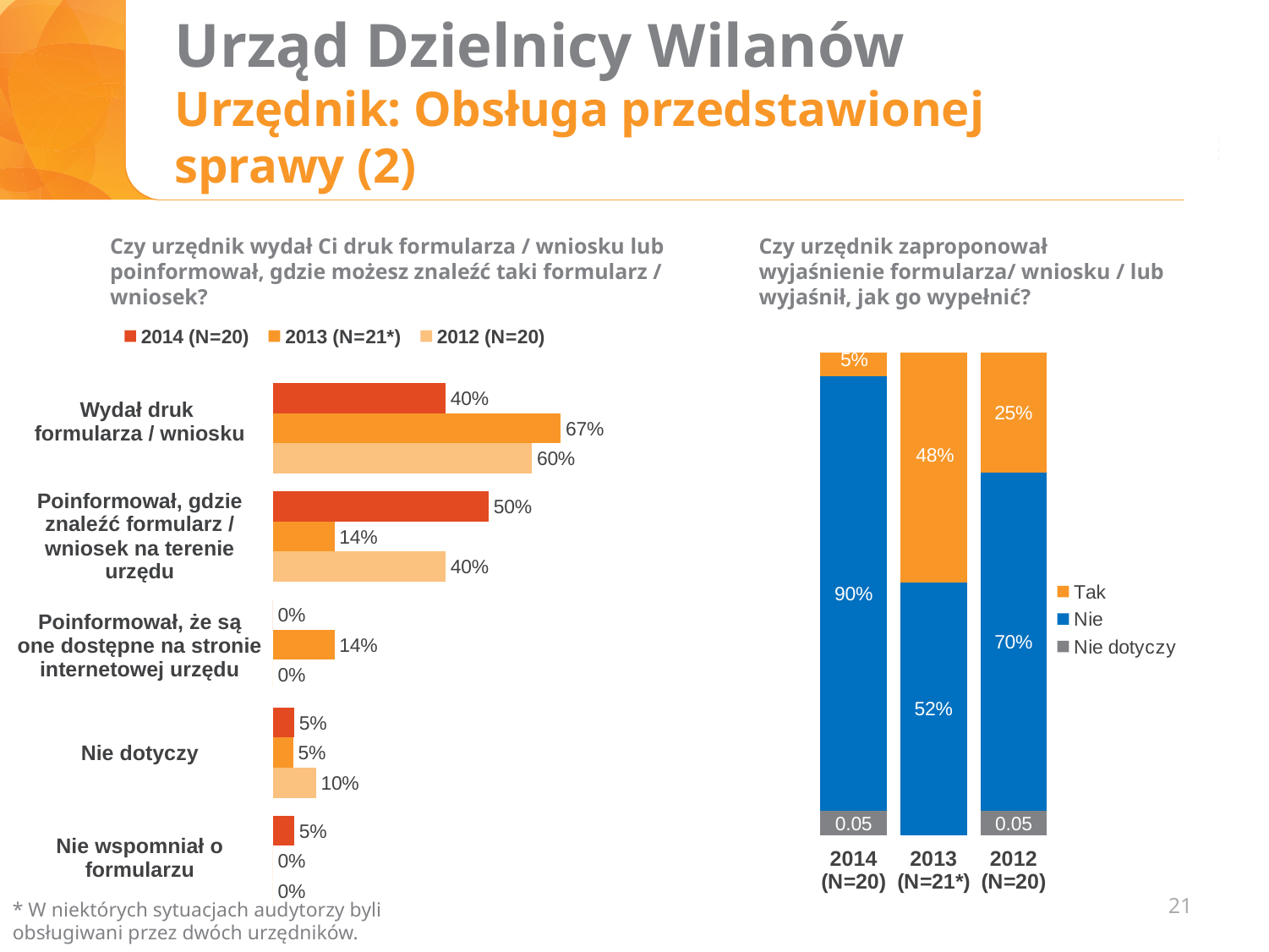
In the right chart, which year has the highest 'Tak' value? 2013 (N=21*) What type of chart is the left chart? Bar chart In the right chart, what is the 'Tak' value for 2012 (N=20)? 25% In the right chart, what is the 'Nie' value for 2013 (N=21*)? 52% In the left chart, how many categories are shown? 5 In the left chart, what is the 2012 (N=20) value for 'Nie dotyczy'? 10% In the left chart, how many series does the legend list? 3 In the left chart, what is the difference between the 2013 and 2014 values for 'Wydał druk formularza / wniosku'? 27 percentage points In the left chart, what is the 2014 (N=20) value for 'Poinformował, gdzie znaleźć formularz / wniosek na terenie urzędu'? 50% In the left chart, what is the 2013 (N=21*) value for 'Wydał druk formularza / wniosku'? 67% In the left chart, which year has the highest value for 'Wydał druk formularza / wniosku'? 2013 (N=21*) In the right chart, how many series does the legend list? 3